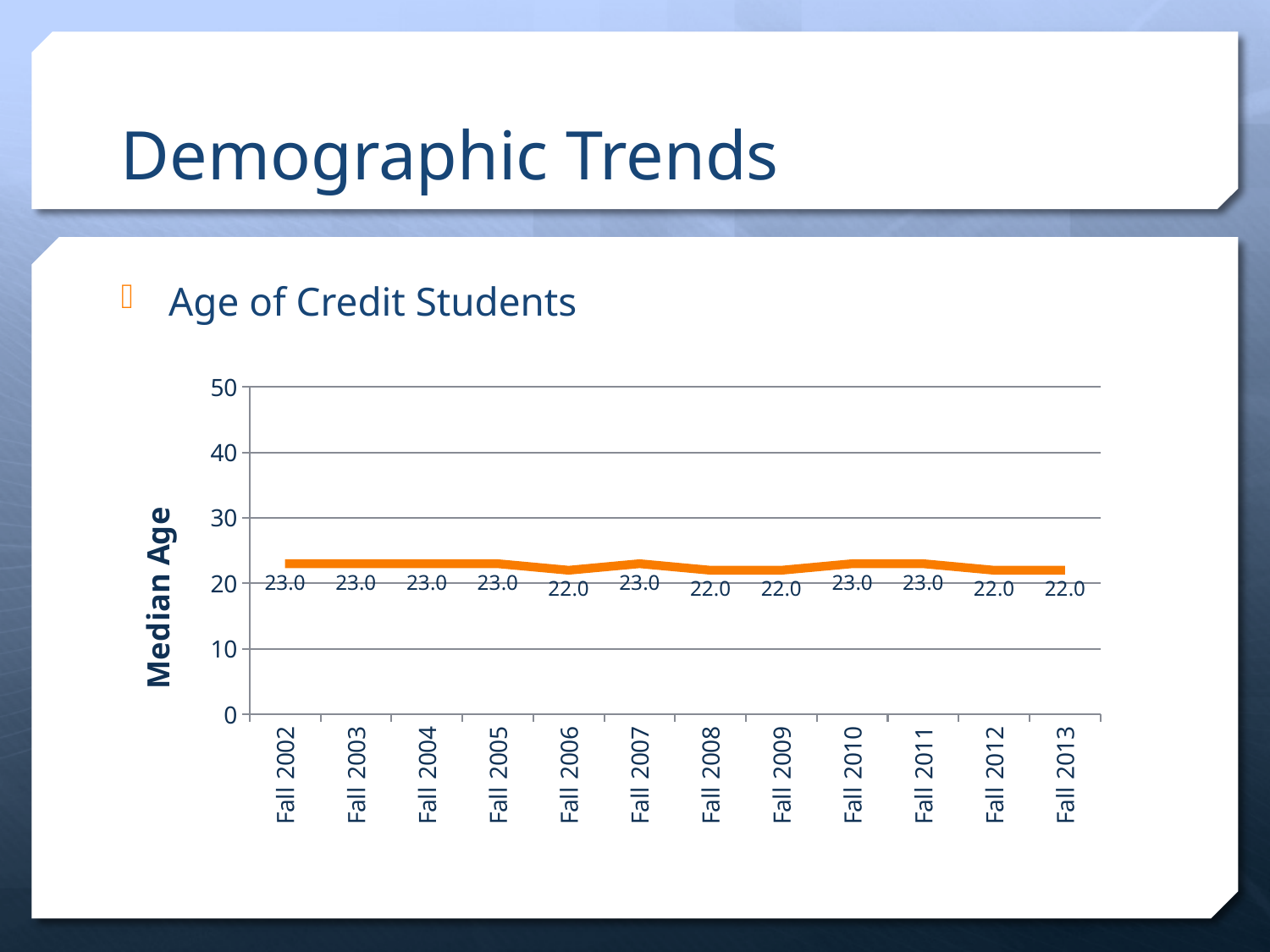
What is the median age for Fall 2002? 23.0 Which is larger, the median age in Fall 2007 or Fall 2008? Fall 2007 What is the label on the vertical axis? Median Age What is the lowest median age value shown on the chart? 22.0 What is the median age for Fall 2013? 22.0 What is the median age for Fall 2010? 23.0 What is the median age for Fall 2006? 22.0 What is the highest median age value shown on the chart? 23.0 What is the difference between the median age in Fall 2005 and Fall 2006? 1.0 How many data points are plotted on the chart? 12 What kind of chart is shown on the slide? line chart Is the median age for Fall 2009 greater or less than 30? less